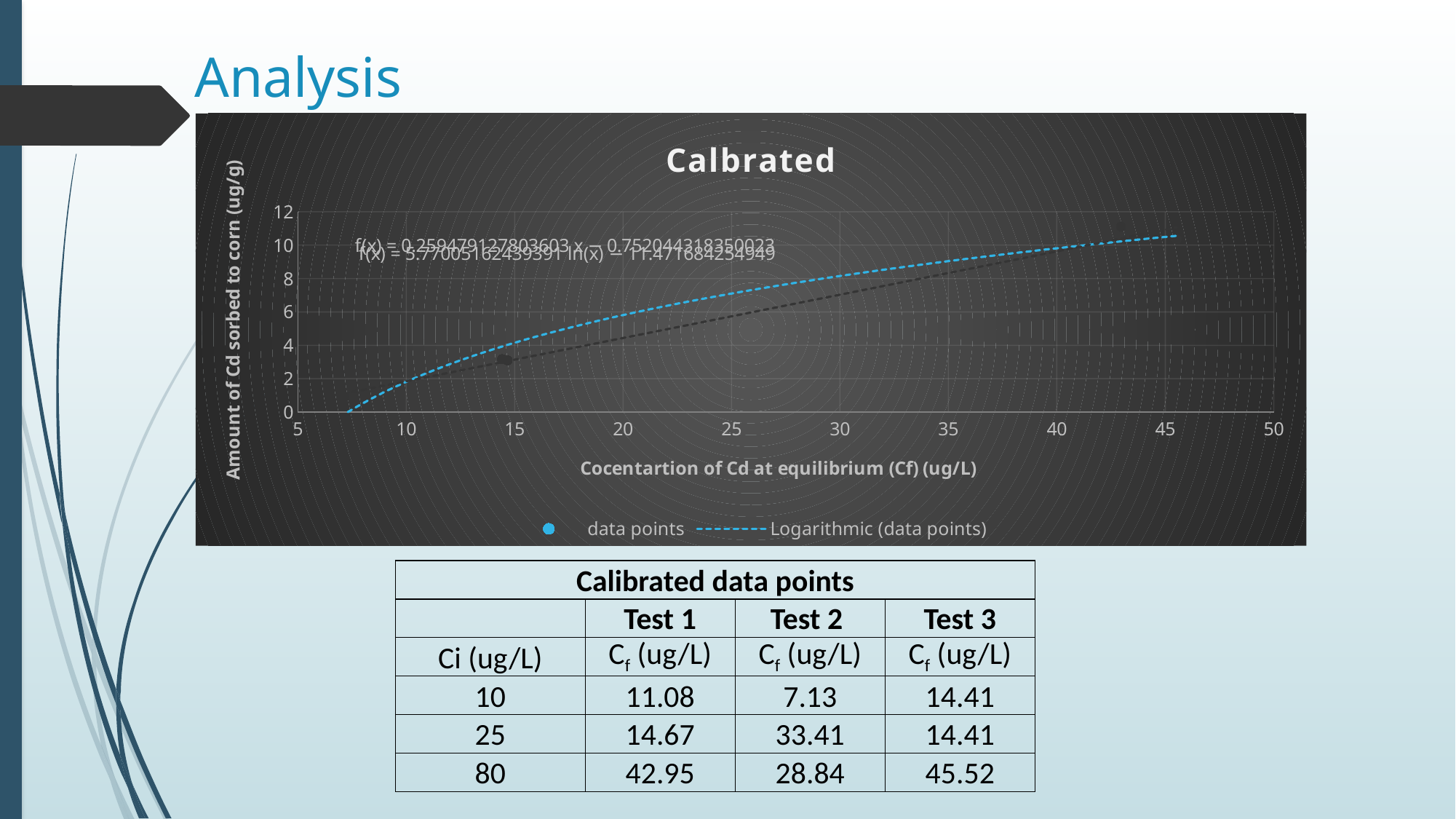
What is the title of the chart? Calbrated Is the value of the logarithmic trendline at a concentration of 35 greater or less than 10? less Is the value of the logarithmic trendline at a concentration of 10 greater or less than 4? less How many entries does the chart legend list? 2 Is the value of the logarithmic trendline at a concentration of 25 greater or less than 8? less Does the logarithmic trendline rise or fall as the concentration of Cd at equilibrium increases? Rises What is the title of the chart's vertical axis? Amount of Cd sorbed to corn (ug/g) What kind of chart is shown on the slide? Scatter chart with a logarithmic trendline